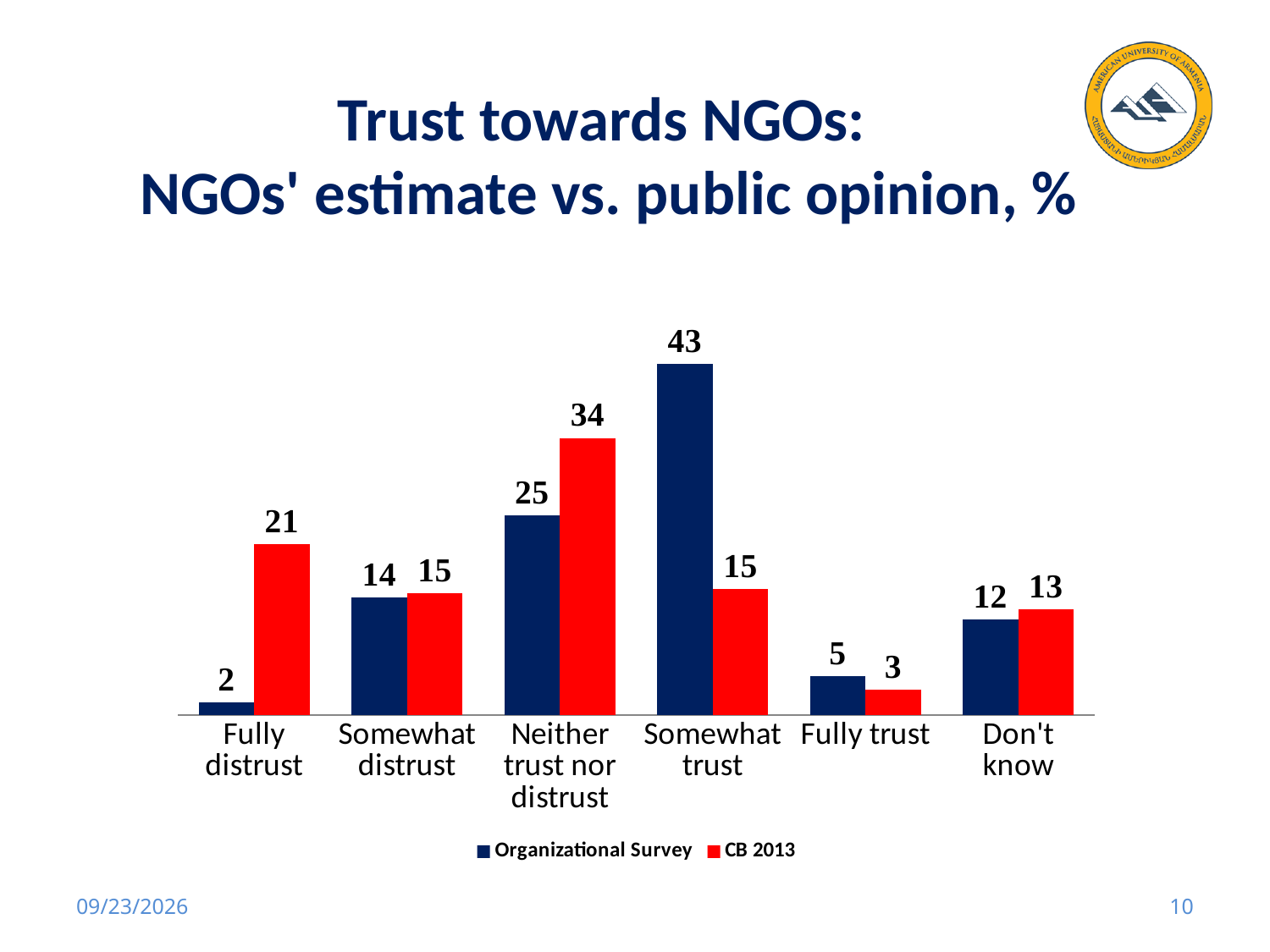
How many series does the legend list? 2 What is the difference between the Organizational Survey and CB 2013 values for Somewhat trust? 28 What is the difference between the CB 2013 values for Fully distrust and Fully trust? 18 What kind of chart is shown on the slide? Bar chart For Fully distrust, which series has the larger value: Organizational Survey or CB 2013? CB 2013 How many categories are shown on the x axis? 6 What is the CB 2013 value for Neither trust nor distrust? 34 What is the CB 2013 value for Fully distrust? 21 What is the Organizational Survey value for Somewhat trust? 43 Which category has the lowest Organizational Survey value? Fully distrust Which series is shown in red in the legend? CB 2013 Which category has the highest CB 2013 value? Neither trust nor distrust